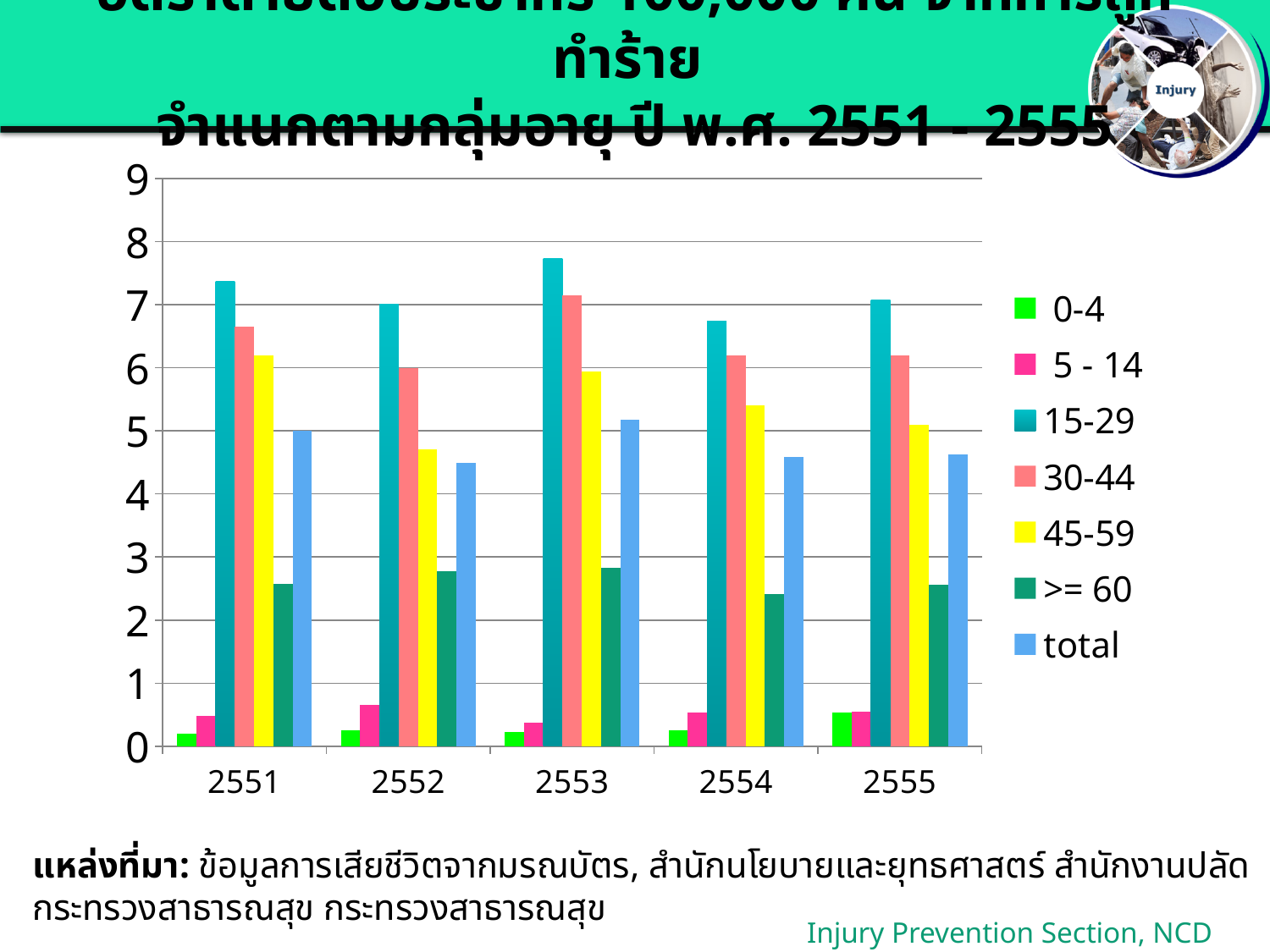
In 2551, which is larger: the value for 15-29 or the value for 30-44? 15-29 Is the value for the 0-4 group in 2555 greater or less than 1? less What kind of chart is shown on the slide? bar chart Is the value for the 45-59 group in 2554 greater or less than 5? greater Which legend entry is listed first? 0-4 Is the value for the 15-29 group in 2553 greater or less than 7? greater In which year is the value for the 15-29 group highest? 2553 Which age group has the highest value in 2553? 15-29 Which age group has the lowest value in 2551? 0-4 How many series does the legend list? 7 How many years (categories) are shown on the x axis? 5